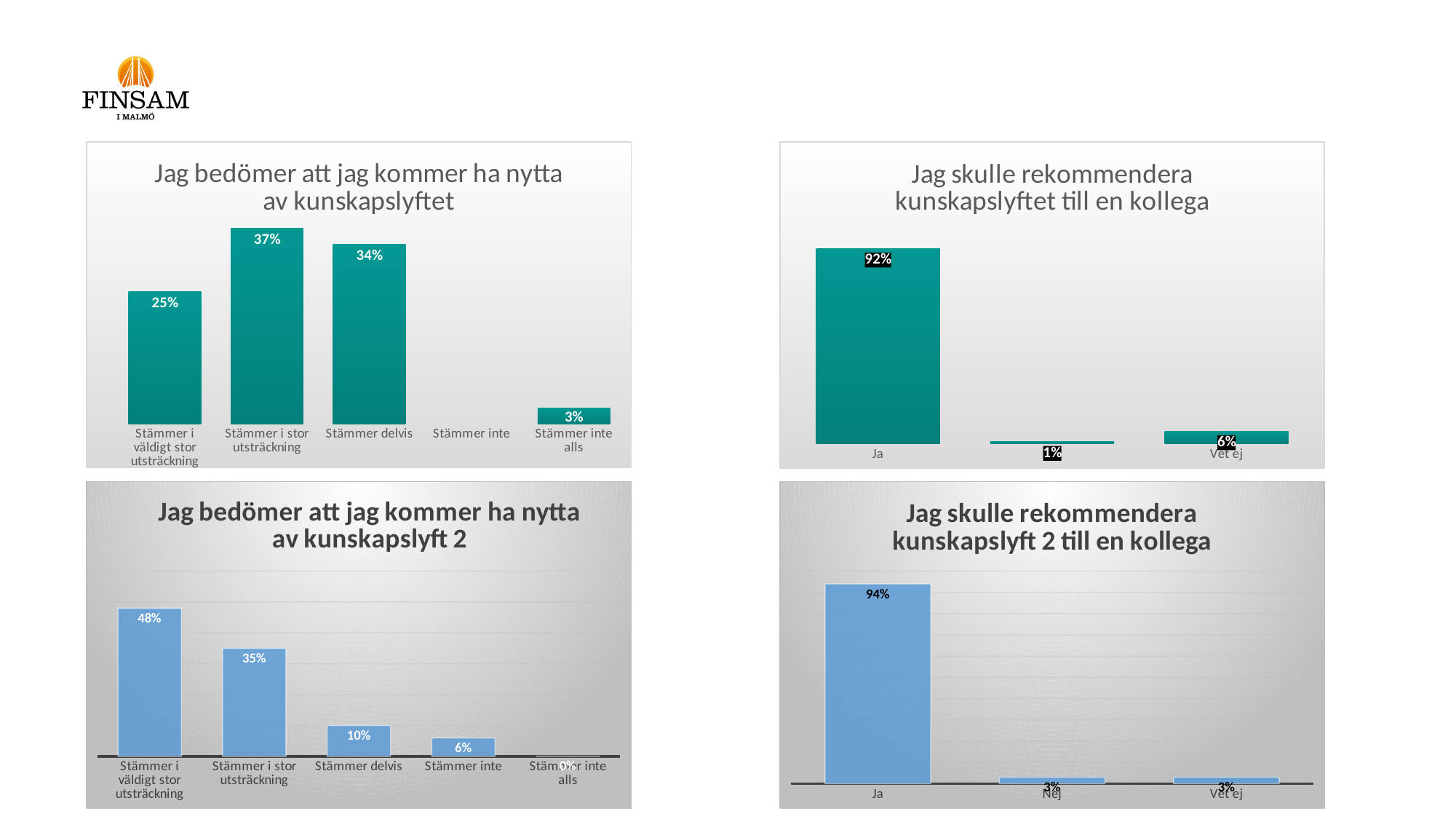
In the chart titled "Jag skulle rekommendera kunskapslyft 2 till en kollega", what is the value for "Ja"? 94% In the chart titled "Jag bedömer att jag kommer ha nytta av kunskapslyftet", which category has the highest value? Stämmer i stor utsträckning In the chart titled "Jag skulle rekommendera kunskapslyft 2 till en kollega", what is the difference between "Ja" and "Nej"? 91% In the chart titled "Jag bedömer att jag kommer ha nytta av kunskapslyftet", what is the difference between "Stämmer i stor utsträckning" and "Stämmer i väldigt stor utsträckning"? 12% In the chart titled "Jag bedömer att jag kommer ha nytta av kunskapslyftet", what is the value for "Stämmer i stor utsträckning"? 37% What kind of chart is the one titled "Jag skulle rekommendera kunskapslyftet till en kollega"? bar chart In the chart titled "Jag bedömer att jag kommer ha nytta av kunskapslyft 2", do the values rise or fall from left to right along the x axis? fall In the chart titled "Jag bedömer att jag kommer ha nytta av kunskapslyft 2", how many categories are shown on the x axis? 5 In the chart titled "Jag bedömer att jag kommer ha nytta av kunskapslyft 2", which is larger: "Stämmer delvis" or "Stämmer inte"? Stämmer delvis In the chart titled "Jag bedömer att jag kommer ha nytta av kunskapslyft 2", what is the value for "Stämmer i väldigt stor utsträckning"? 48% In the chart titled "Jag skulle rekommendera kunskapslyftet till en kollega", what is the value for "Vet ej"? 6% In the chart titled "Jag skulle rekommendera kunskapslyftet till en kollega", which category has the lowest value? Nej